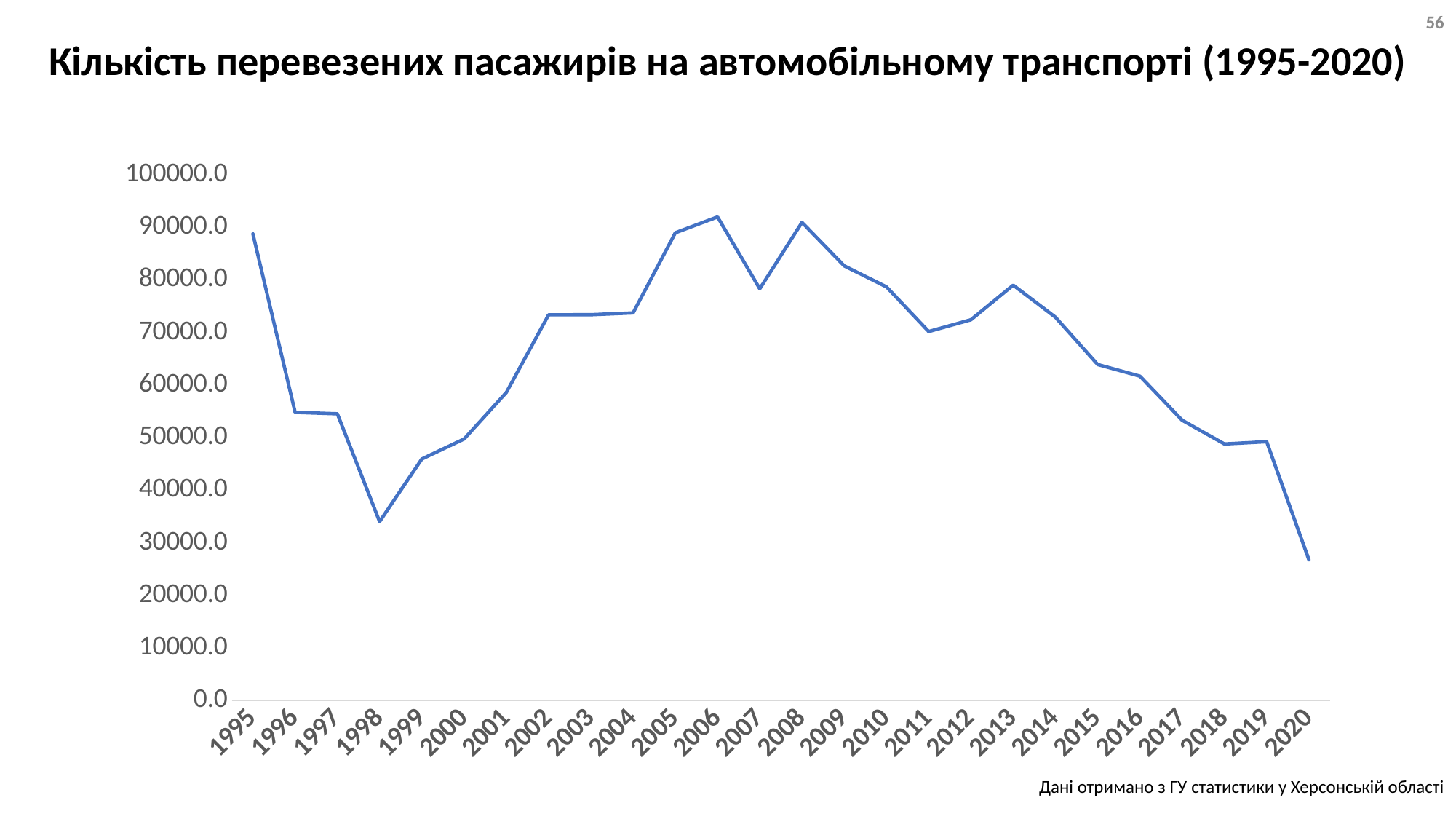
Is the value for 2020 greater or less than 30000.0? less Which year has the larger value, 1998 or 2020? 1998 Is the value for 1998 greater or less than 40000.0? less Is the value for 1995 greater or less than 80000.0? greater Which year has the lowest value on the chart? 2020 Do the values rise or fall from 2013 to 2020? fall What kind of chart is shown on the slide? line chart Which year has the larger value, 2006 or 2007? 2006 How many years (data points) are plotted along the x axis? 26 What is the title of the chart? Кількість перевезених пасажирів на автомобільному транспорті (1995-2020)